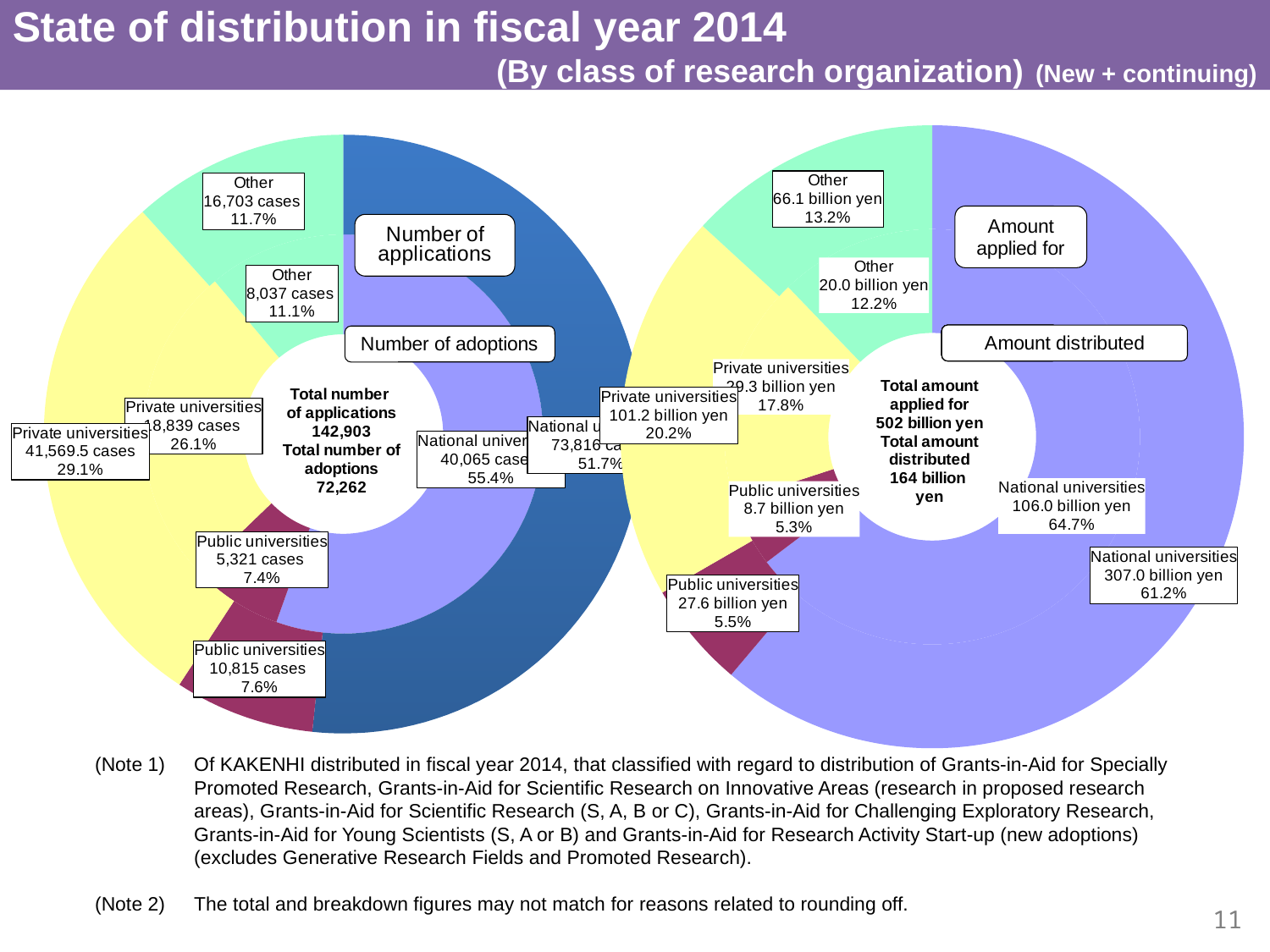
What kind of chart is used on the left side of the slide? Doughnut chart On the left chart, what share of the number of adoptions is attributed to Other? 11.1% On the right chart, what share of the amount distributed went to National universities? 64.7% On the left chart, what is the total number of adoptions? 72,262 On the right chart, what is the total amount distributed? 164 billion yen On the left chart, which class of research organization has the lowest number of adoptions? Public universities On the left chart, what is the difference between the number of applications and the number of adoptions for Public universities? 5,494 cases On the right chart, which class of research organization received the smallest amount distributed? Public universities On the right chart, what amount was applied for by National universities? 307.0 billion yen On the left chart, how many cases of applications are shown for Private universities? 41,569.5 cases On the left chart, what is the total number of applications? 142,903 On the right chart, which is larger: the amount applied for by Other or by Public universities? Other